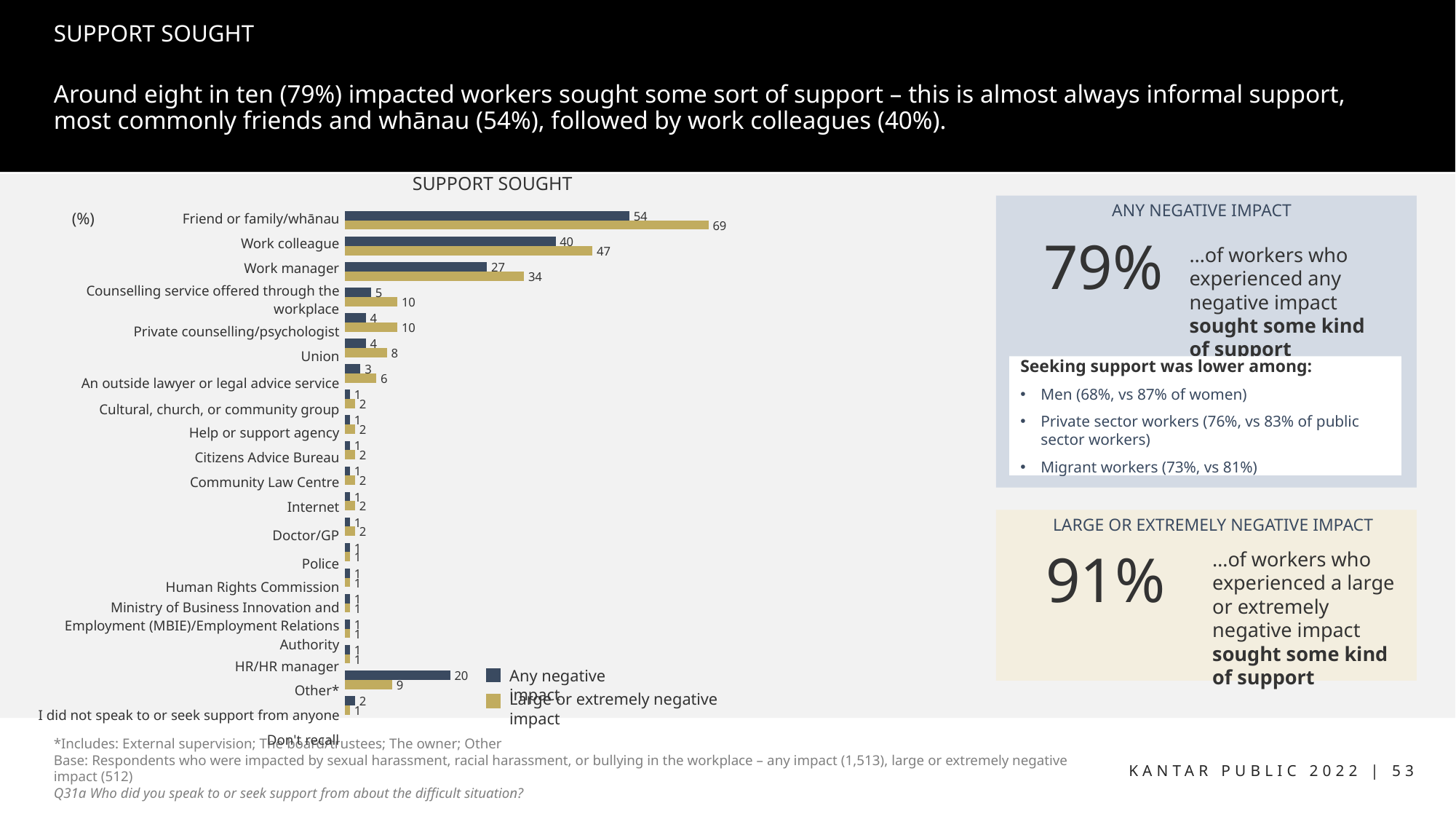
What type of chart is the SUPPORT SOUGHT chart? Bar chart In the SUPPORT SOUGHT chart, what is the difference between the two series values for Work colleague? 7 In the SUPPORT SOUGHT chart, what is the value for Friend or family/whānau in the 'Large or extremely negative impact' series? 69 In the SUPPORT SOUGHT chart, which colour represents the 'Any negative impact' series? Dark blue In the SUPPORT SOUGHT chart, which has the larger 'Any negative impact' value: Work colleague or Work manager? Work colleague In the SUPPORT SOUGHT chart, what is the value for Work colleague in the 'Large or extremely negative impact' series? 47 In the SUPPORT SOUGHT chart, what is the value for Union in the 'Large or extremely negative impact' series? 8 How many series does the legend of the SUPPORT SOUGHT chart list? 2 In the SUPPORT SOUGHT chart, what percentage of workers with any negative impact sought support from a friend or family/whānau? 54 In the SUPPORT SOUGHT chart, what is the value for Work manager in the 'Any negative impact' series? 27 In the SUPPORT SOUGHT chart, which source of support has the highest value in the 'Any negative impact' series? Friend or family/whānau In the SUPPORT SOUGHT chart, what is the difference between the 'Large or extremely negative impact' and 'Any negative impact' values for Friend or family/whānau? 15